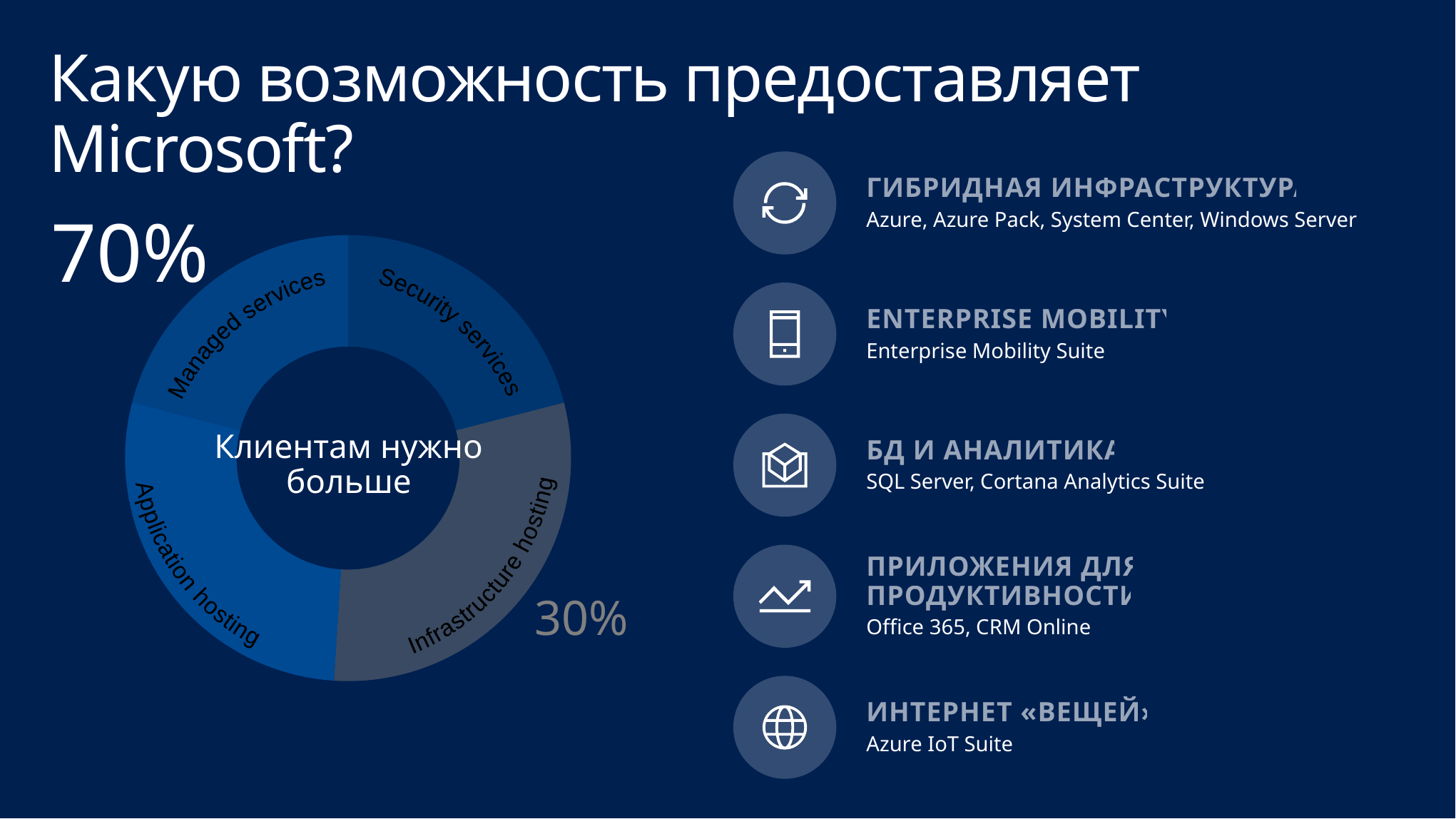
What percentage is printed in grey next to the Infrastructure hosting segment? 30% What text is printed in the centre of the donut chart? Клиентам нужно больше How many segments does the donut chart have? 4 What large percentage is printed to the upper left of the donut chart? 70% Name the four segments of the donut chart. Managed services, Security services, Infrastructure hosting, Application hosting Which segment of the donut chart sits between Managed services and Infrastructure hosting going clockwise from the top? Security services What kind of chart is shown on the slide? Donut (pie) chart Which segment of the donut chart is shown in grey rather than blue? Infrastructure hosting